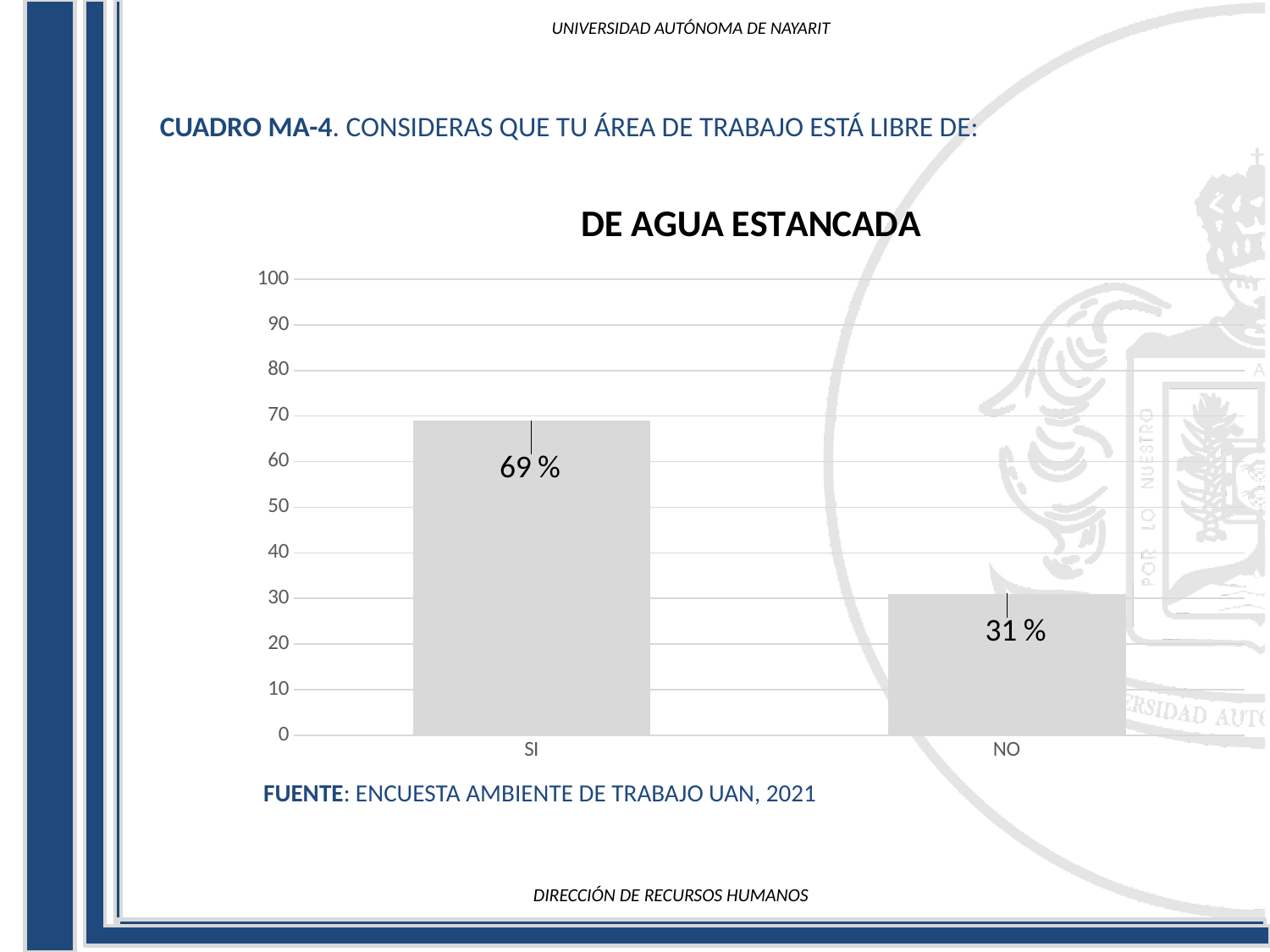
What is the maximum value shown on the y axis? 100 How many categories are shown on the x axis? 2 What is the difference between the values for SI and NO? 38 % Which is larger, the value for SI or the value for NO? SI What is the value for NO? 31 % What is the title of the chart? DE AGUA ESTANCADA Which category has the lowest value? NO Is the value for NO greater or less than 40? less Is the value for SI greater or less than 60? greater What kind of chart is shown on the slide? bar chart Which category has the highest value? SI What is the value for SI? 69 %